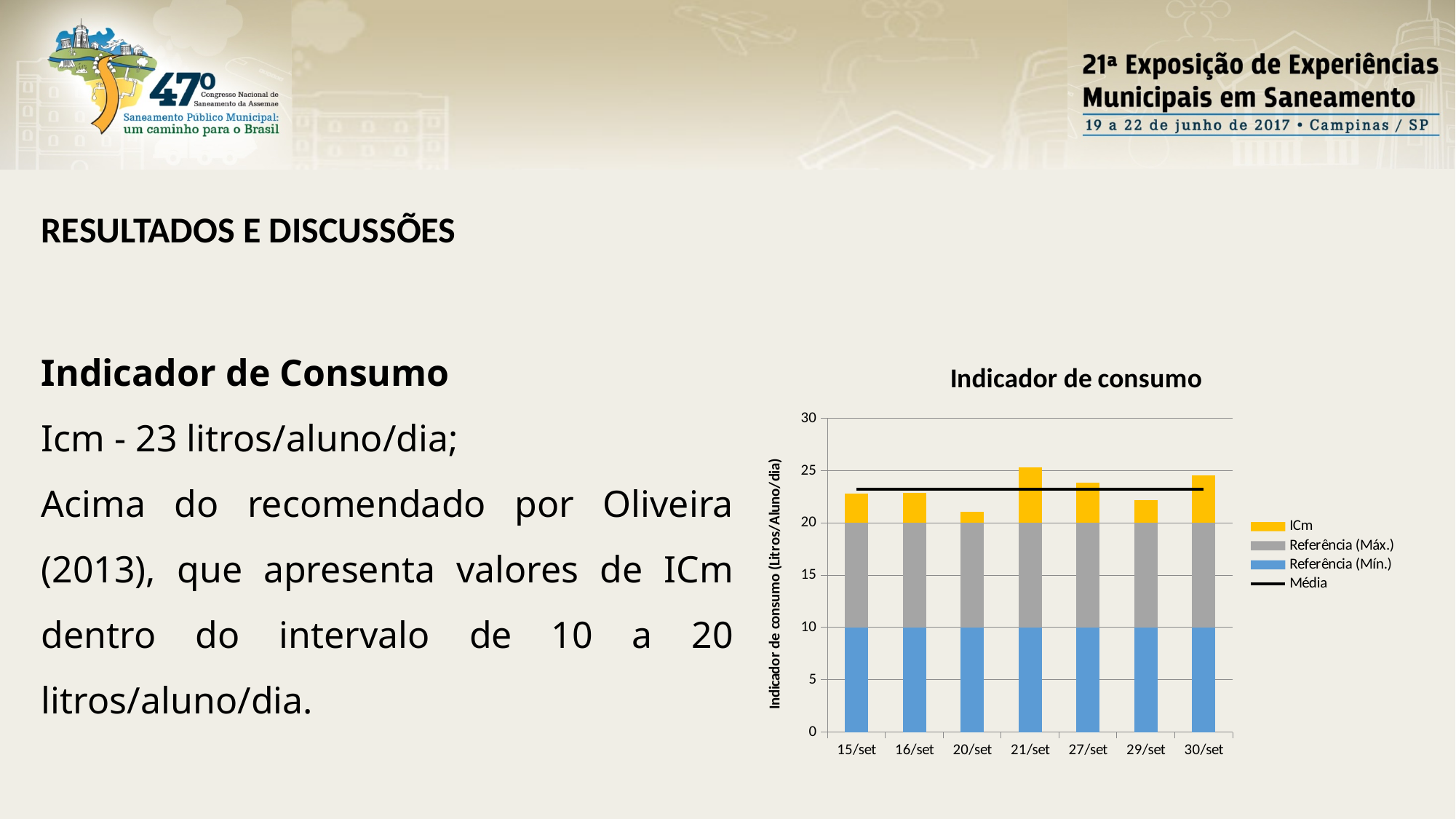
On which date does the stacked bar reach its lowest total? 20/set At which axis value does the blue Referência (Mín.) segment end in every bar? 10 How many series does the chart legend list? 4 Is the total of the stacked bar for 30/set greater or less than 20? greater What is the title of the chart? Indicador de consumo What kind of chart is shown on the slide? combination bar and line chart Which series is drawn as a black horizontal line in the chart? Média How many dates are shown on the x axis of the chart? 7 Which stacked bar is taller, 21/set or 20/set? 21/set On which date does the stacked bar reach its highest total? 21/set Is the total of the stacked bar for 20/set greater or less than 25? less